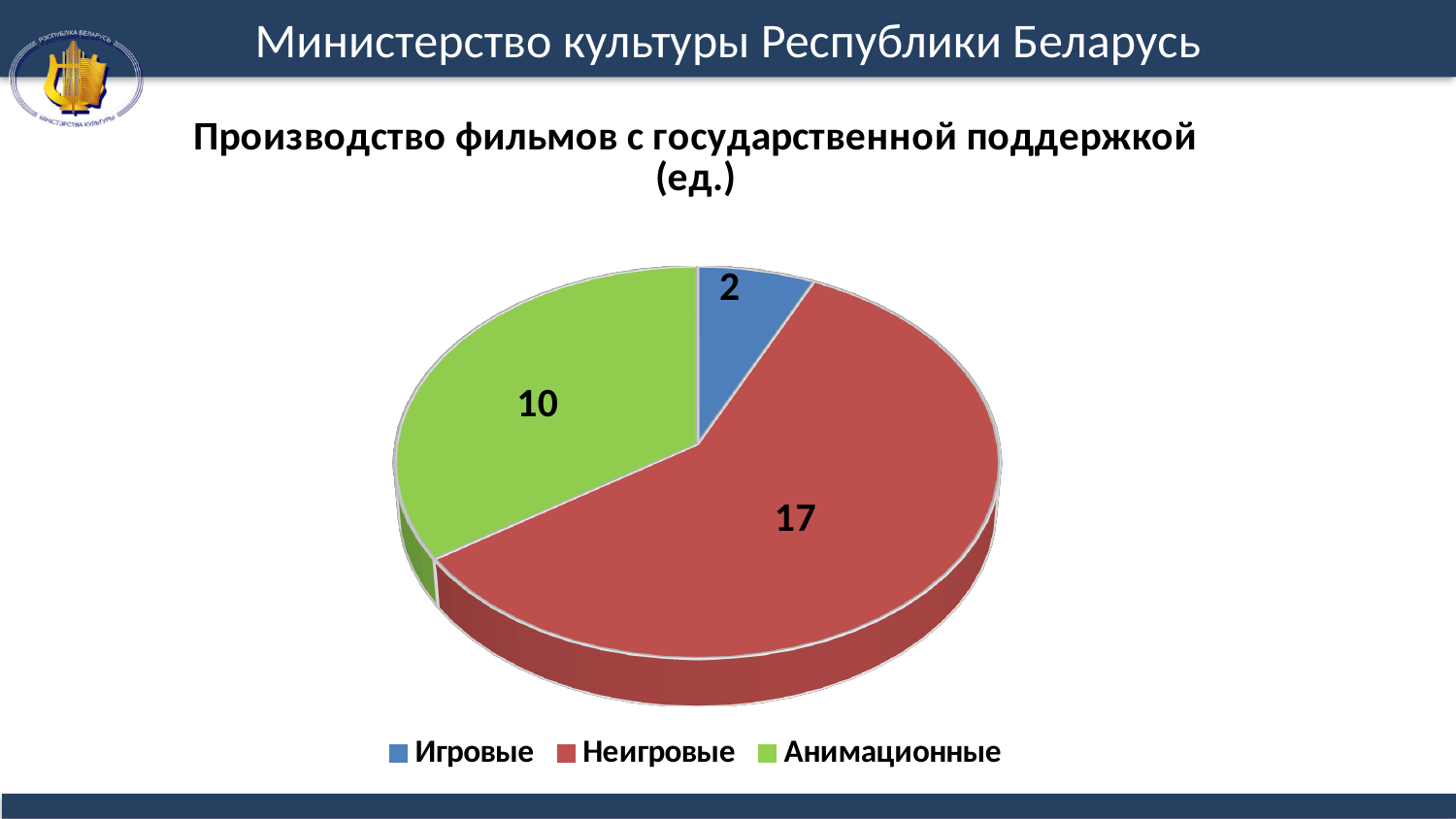
Which is larger, the value for Анимационные or the value for Игровые? Анимационные What is the total of all slices in the pie chart? 29 How many categories does the pie chart have? 3 What is the difference between the values for Неигровые and Анимационные? 7 Which category has the largest slice of the pie? Неигровые What is the title of the chart? Производство фильмов с государственной поддержкой (ед.) What is the value for Неигровые? 17 What is the value for Игровые? 2 Which category has the smallest slice of the pie? Игровые What type of chart is shown on the slide? pie chart What is the value for Анимационные? 10